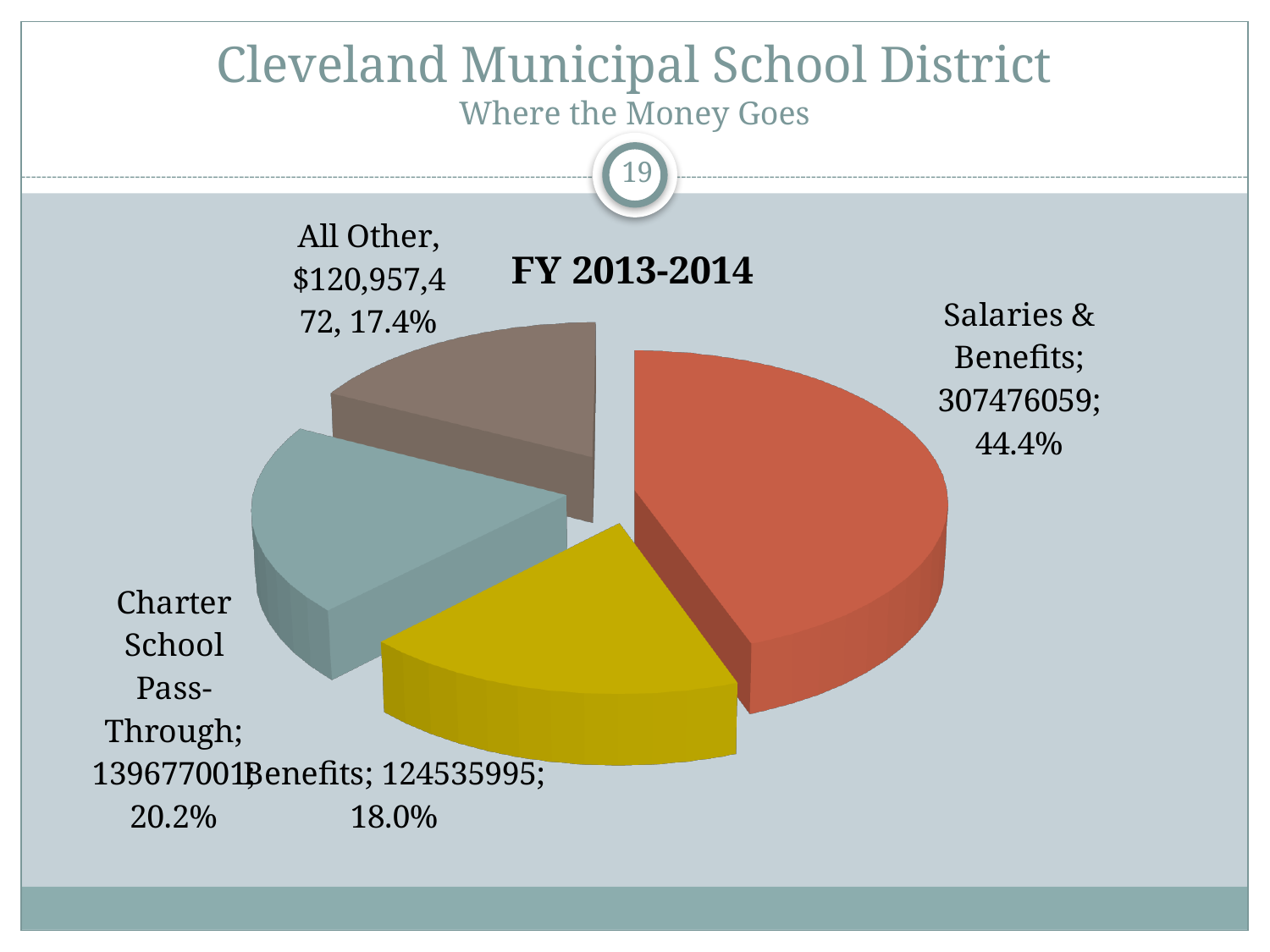
What is the value shown for Salaries & Benefits? 307476059 What is the value shown for Benefits? 124535995 Which category has the smallest slice of the pie chart? All Other What is the title of the chart? FY 2013-2014 Which category has the largest slice of the pie chart? Salaries & Benefits What percentage share does Benefits have in the pie chart? 18.0% What percentage share does All Other have in the pie chart? 17.4% What percentage share does Salaries & Benefits have in the pie chart? 44.4% How many slices does the pie chart have? 4 What is the value shown for All Other? $120,957,472 What kind of chart is shown on the slide? Pie chart